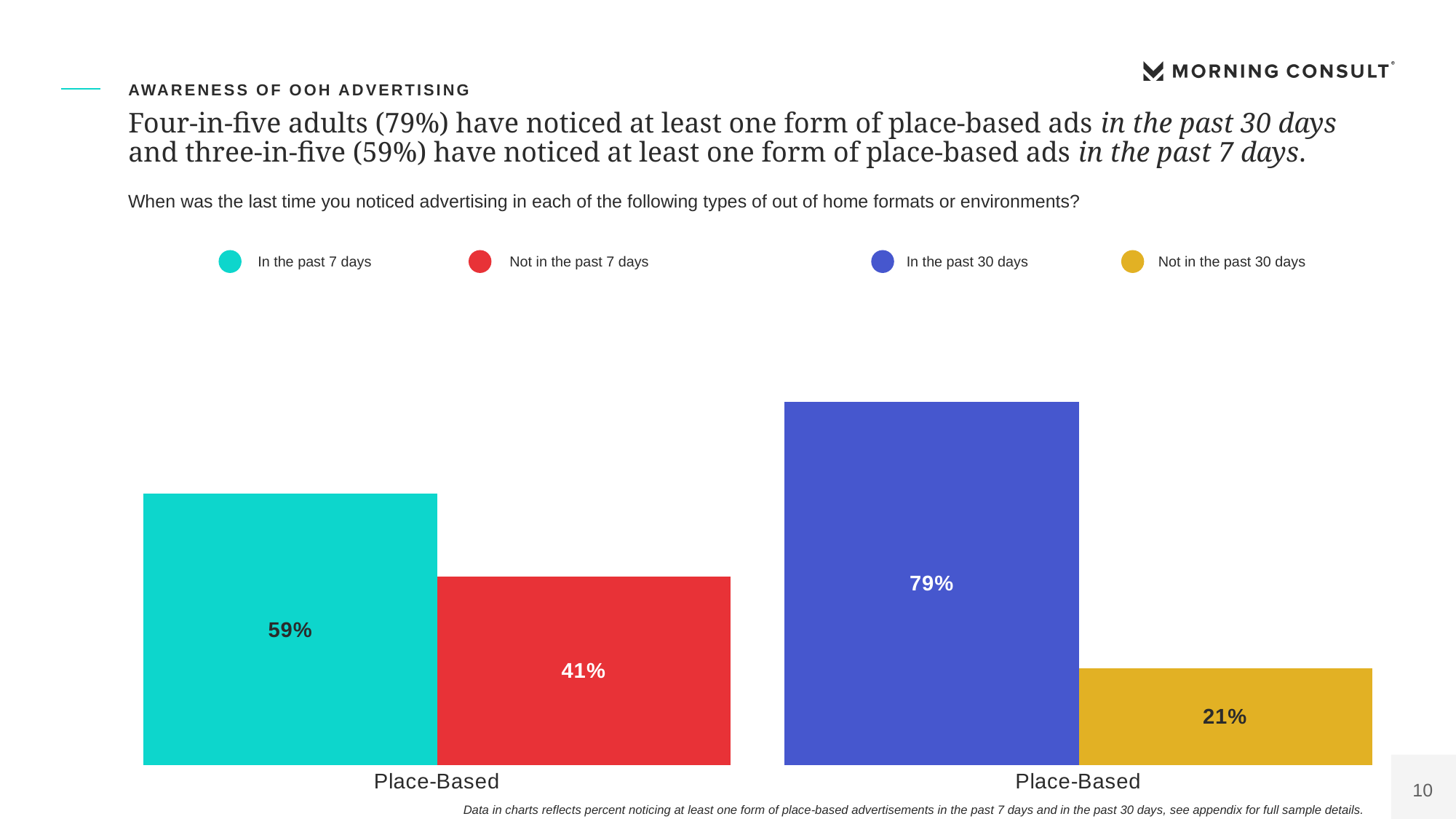
What percentage of adults noticed place-based ads in the past 7 days? 59% Which series has the lowest value on the chart? Not in the past 30 days What colour is the bar for 'In the past 30 days'? Blue How many series does the legend list? 4 What kind of chart is shown on the slide? Bar chart What percentage of adults did not notice place-based ads in the past 30 days? 21% Which series has the highest value on the chart? In the past 30 days Which is larger: the 'Not in the past 7 days' value or the 'Not in the past 30 days' value? Not in the past 7 days What is the difference between the share who noticed place-based ads in the past 30 days and the share who noticed them in the past 7 days? 20% What percentage of adults did not notice place-based ads in the past 7 days? 41% What is the difference between the 'In the past 7 days' and 'Not in the past 7 days' values? 18% What percentage of adults noticed place-based ads in the past 30 days? 79%